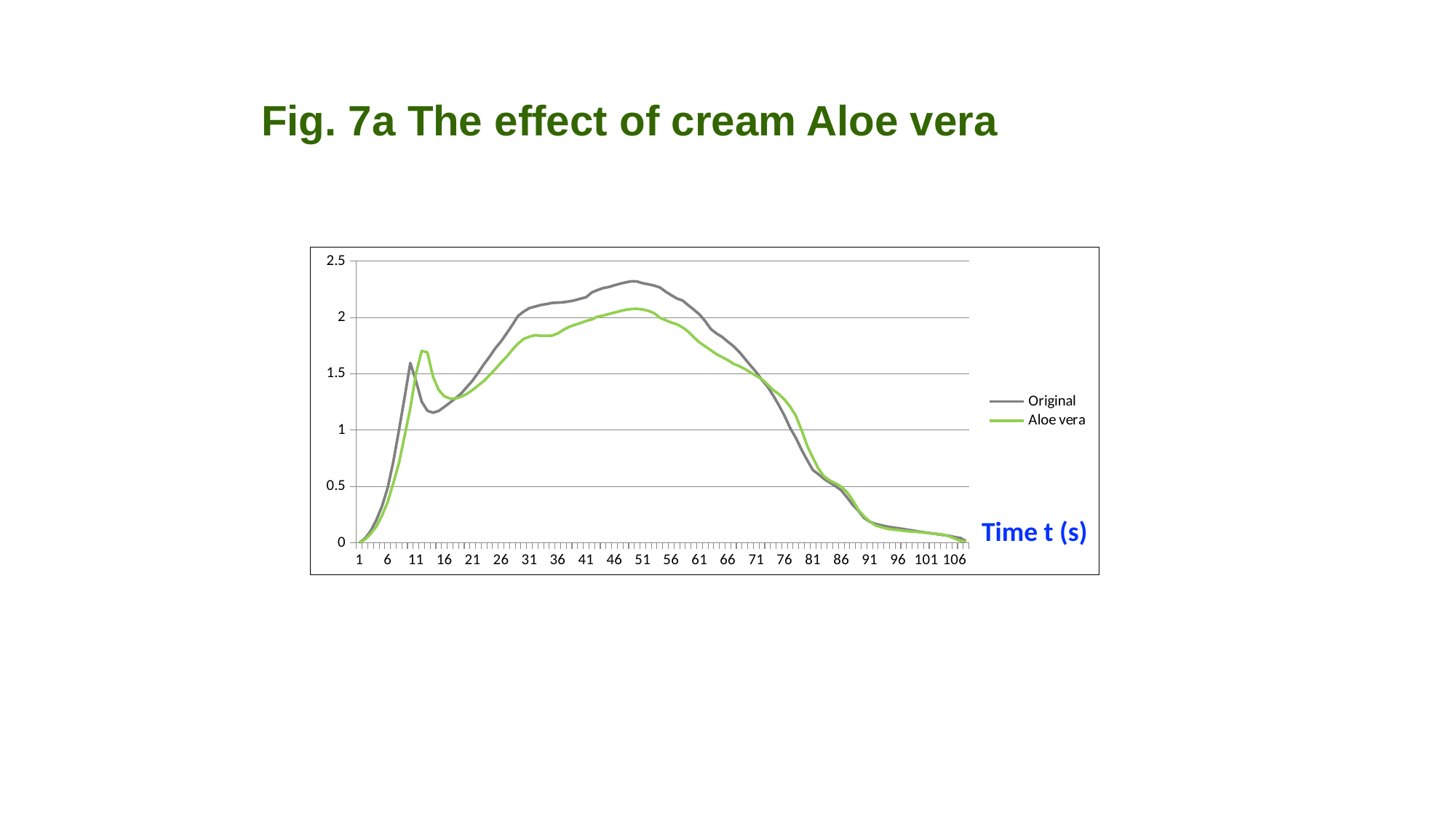
At time 46, which series has the higher value, Original or Aloe vera? Original What are the two series named in the legend? Original and Aloe vera Is the peak value of the Original series greater or less than 2? greater At time 81, which series has the higher value, Original or Aloe vera? Aloe vera Is the value of the Original series at time 96 greater or less than 0.5? less Is the value of the Aloe vera series at time 31 greater or less than 1.5? greater Which series reaches the higher maximum value? Original What kind of chart is shown on the slide? line chart How many series does the legend list? 2 What is the label on the x axis of the chart? Time t (s) Between time 51 and time 106, do the values of the Original series rise or fall? fall